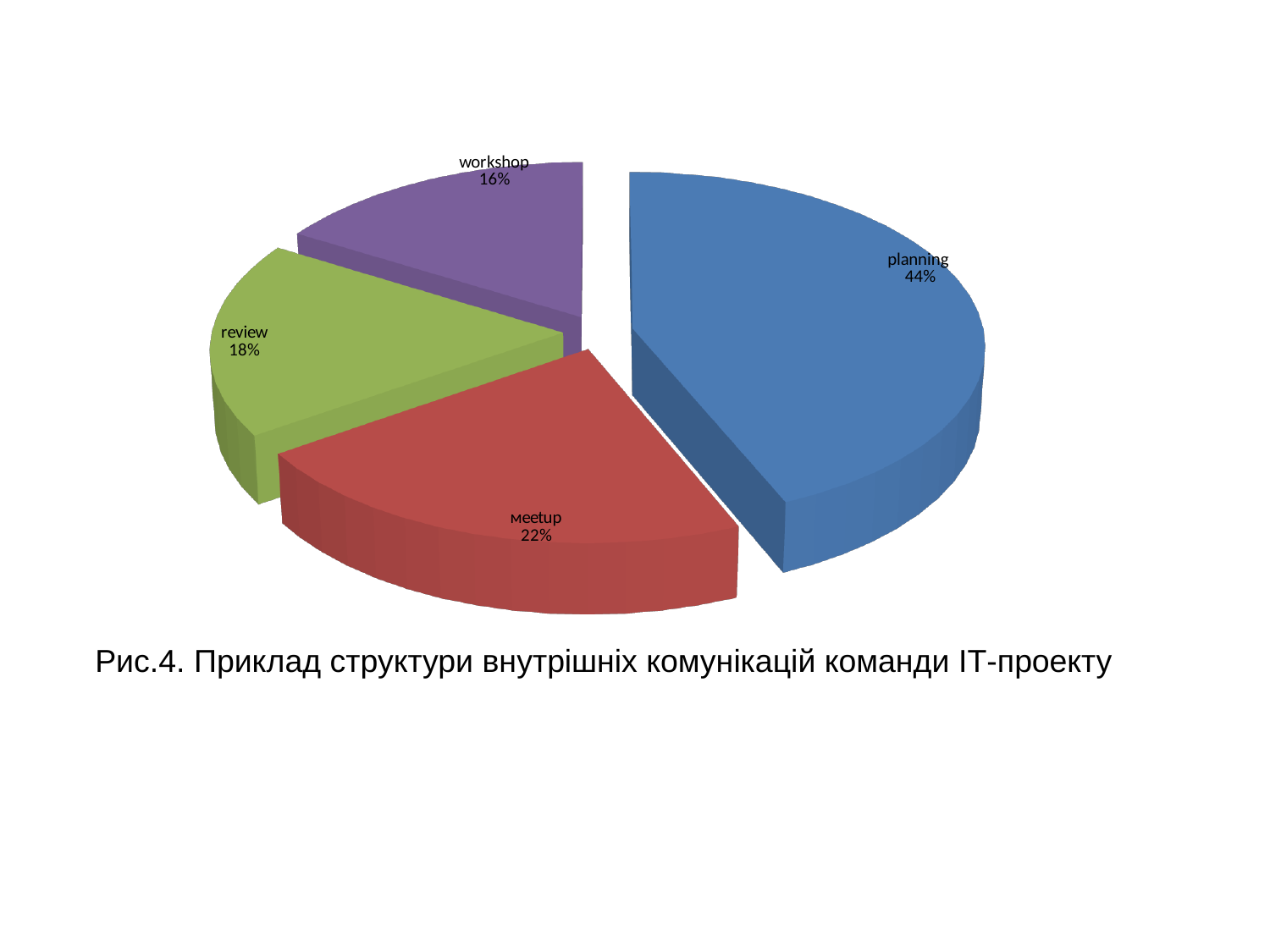
What share of the pie does the review slice represent? 18% Which category has the smallest slice of the pie? workshop What is the difference in percentage points between the review and workshop slices? 2 How many slices does the pie chart have? 4 What share of the pie does the meetup slice represent? 22% What share of the pie does the planning slice represent? 44% What kind of chart is shown on the slide? pie chart What is the difference in percentage points between the planning and meetup slices? 22 Which category has the largest slice of the pie? planning What colour is the planning slice? blue Which slice is larger, meetup or review? meetup